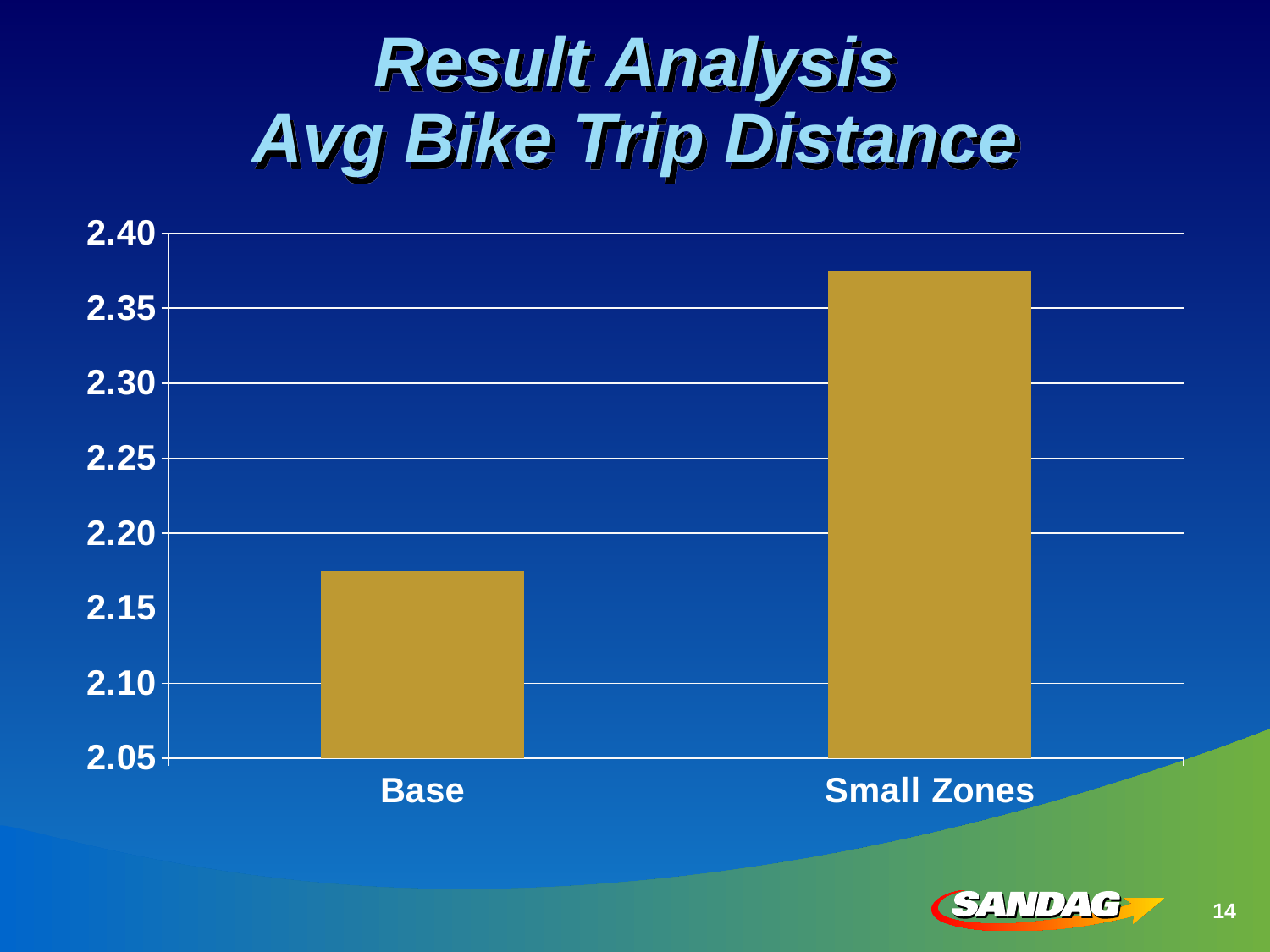
What is the title of the slide containing the chart? Result Analysis Avg Bike Trip Distance Is the value for Base greater or less than 2.20? less Which is larger, the value for Base or the value for Small Zones? Small Zones Is the value for Small Zones greater or less than 2.40? less How many categories are shown on the x axis? 2 Which category has the lowest average bike trip distance? Base Which category has the highest average bike trip distance? Small Zones Is the value for Small Zones greater or less than 2.35? greater Do the values rise or fall from Base to Small Zones? rise What is the lowest value shown on the y axis? 2.05 What kind of chart is shown on the slide? bar chart